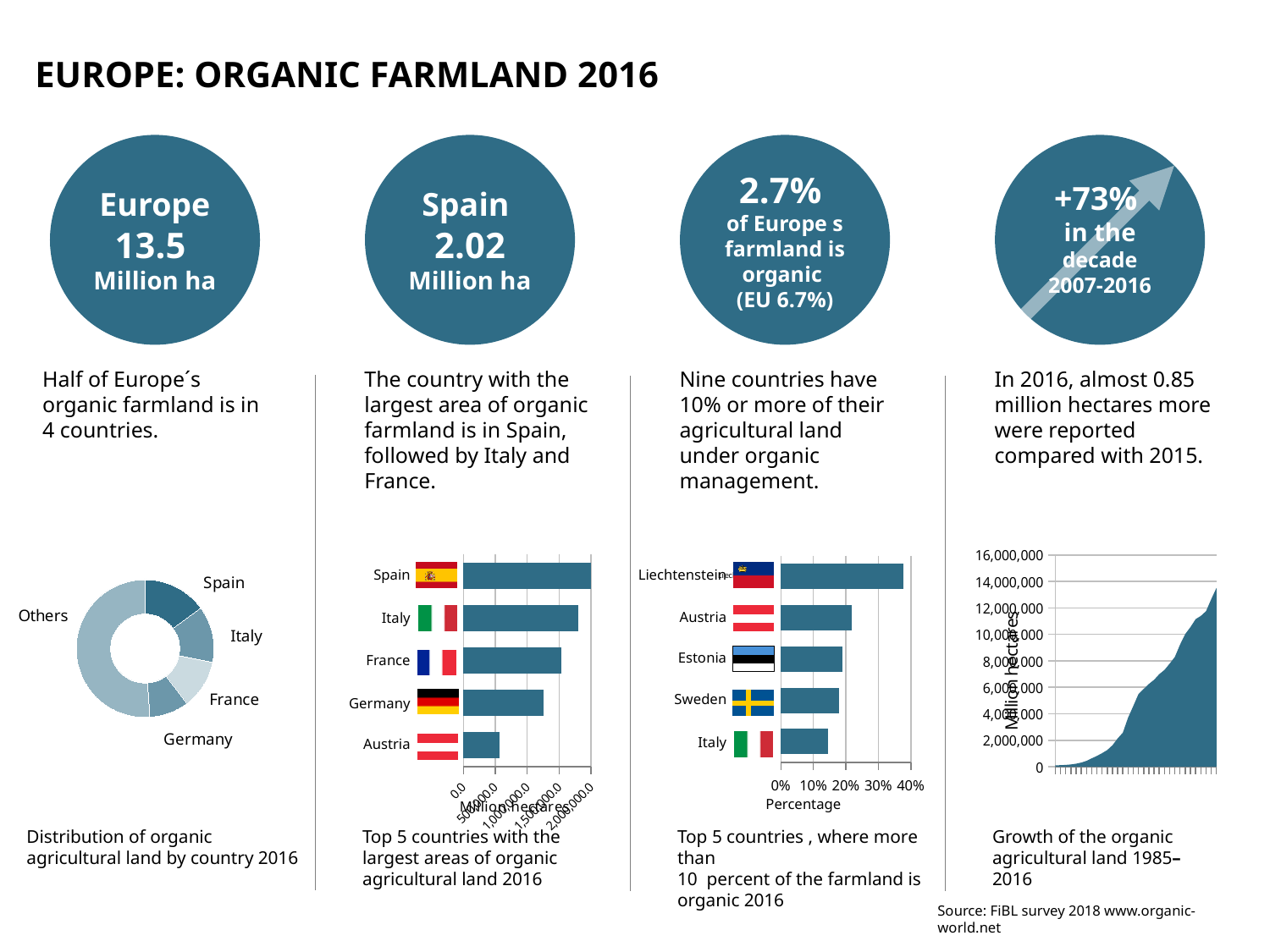
In the chart 'Top 5 countries, where more than 10 percent of the farmland is organic 2016', which country has the highest percentage? Liechtenstein In the chart 'Top 5 countries with the largest areas of organic agricultural land 2016', which country has the largest area? Spain In the chart 'Top 5 countries with the largest areas of organic agricultural land 2016', is the value for Austria greater or less than 1,000,000? less In the chart 'Top 5 countries, where more than 10 percent of the farmland is organic 2016', which has the larger value, Austria or Italy? Austria In the chart 'Top 5 countries with the largest areas of organic agricultural land 2016', is the value for Italy greater or less than 1,500,000? greater In the chart 'Top 5 countries with the largest areas of organic agricultural land 2016', which country has the smallest area? Austria In the chart 'Growth of the organic agricultural land 1985–2016', do the values rise or fall over time? rise How many categories are shown in the chart 'Distribution of organic agricultural land by country 2016'? 5 In the chart 'Top 5 countries, where more than 10 percent of the farmland is organic 2016', which country has the lowest percentage? Italy In the chart 'Top 5 countries with the largest areas of organic agricultural land 2016', which has the larger value, France or Germany? France In the chart 'Top 5 countries, where more than 10 percent of the farmland is organic 2016', is the value for Liechtenstein greater or less than 30%? greater How many countries are shown in the chart 'Top 5 countries with the largest areas of organic agricultural land 2016'? 5